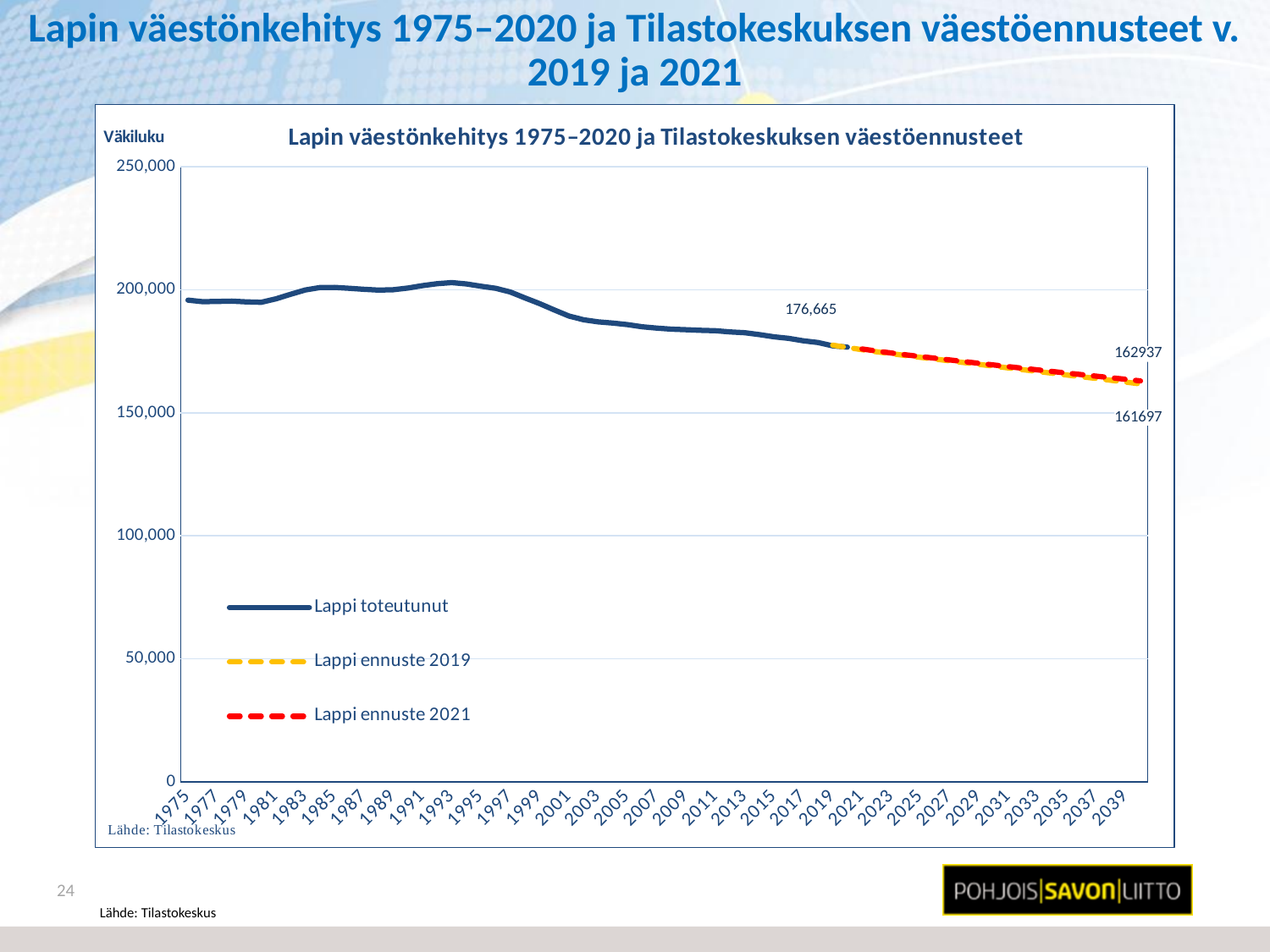
What is the label on the vertical axis of the chart? Väkiluku Is the value for Lappi toteutunut in 2001 greater or less than 200,000? less What is the lower of the two forecast values labelled at the right end of the chart? 161697 What is the higher of the two forecast values labelled at the right end of the chart? 162937 Does the Lappi toteutunut series rise or fall between 2001 and 2019? fall What value is labelled at the end of the Lappi toteutunut (actual) series? 176,665 Is the forecast value for 2039 greater or less than 150,000? greater What is the difference between the labelled actual value 176,665 and the labelled forecast value 162937? 13,728 How many series does the legend list? 3 Which legend entry is drawn with a red dashed line? Lappi ennuste 2021 What is the difference between the two forecast end values labelled 162937 and 161697? 1240 What kind of chart is shown on the slide? line chart